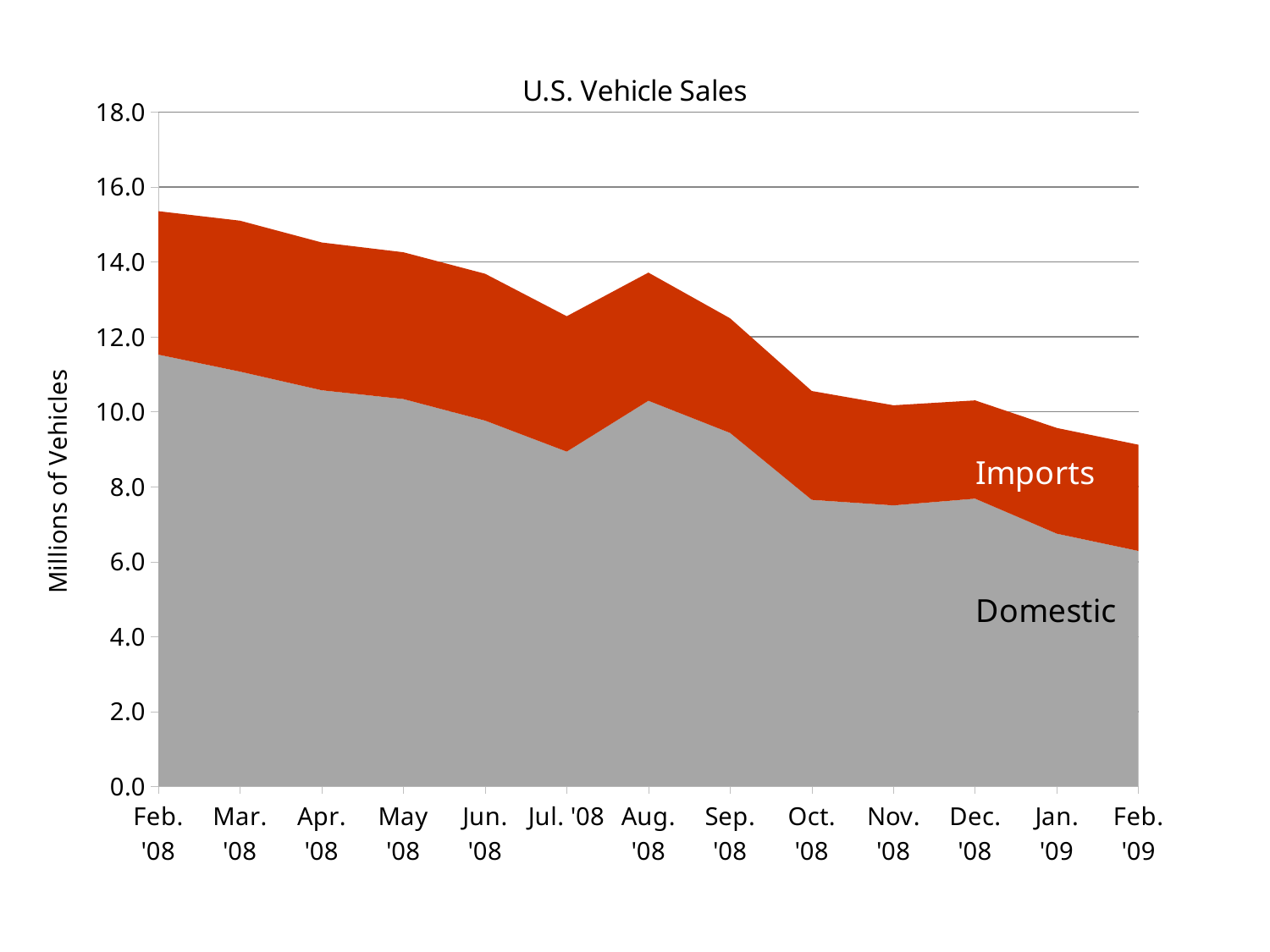
Which month has the highest total vehicle sales? Feb. '08 Is the total of Domestic and Imports for Feb. '09 greater or less than 10.0? less What is the title of the chart? U.S. Vehicle Sales Is the total of Domestic and Imports for Feb. '08 greater or less than 14.0? greater Do total U.S. vehicle sales generally rise or fall from Feb. '08 to Feb. '09? Fall Is the Domestic value for Feb. '08 greater or less than 10.0? greater What kind of chart is shown on the slide? Area chart How many months are shown along the x axis? 13 Which is larger, the Domestic value for Jul. '08 or for Aug. '08? Aug. '08 How many series are plotted in the chart? 2 What is the label on the vertical axis? Millions of Vehicles